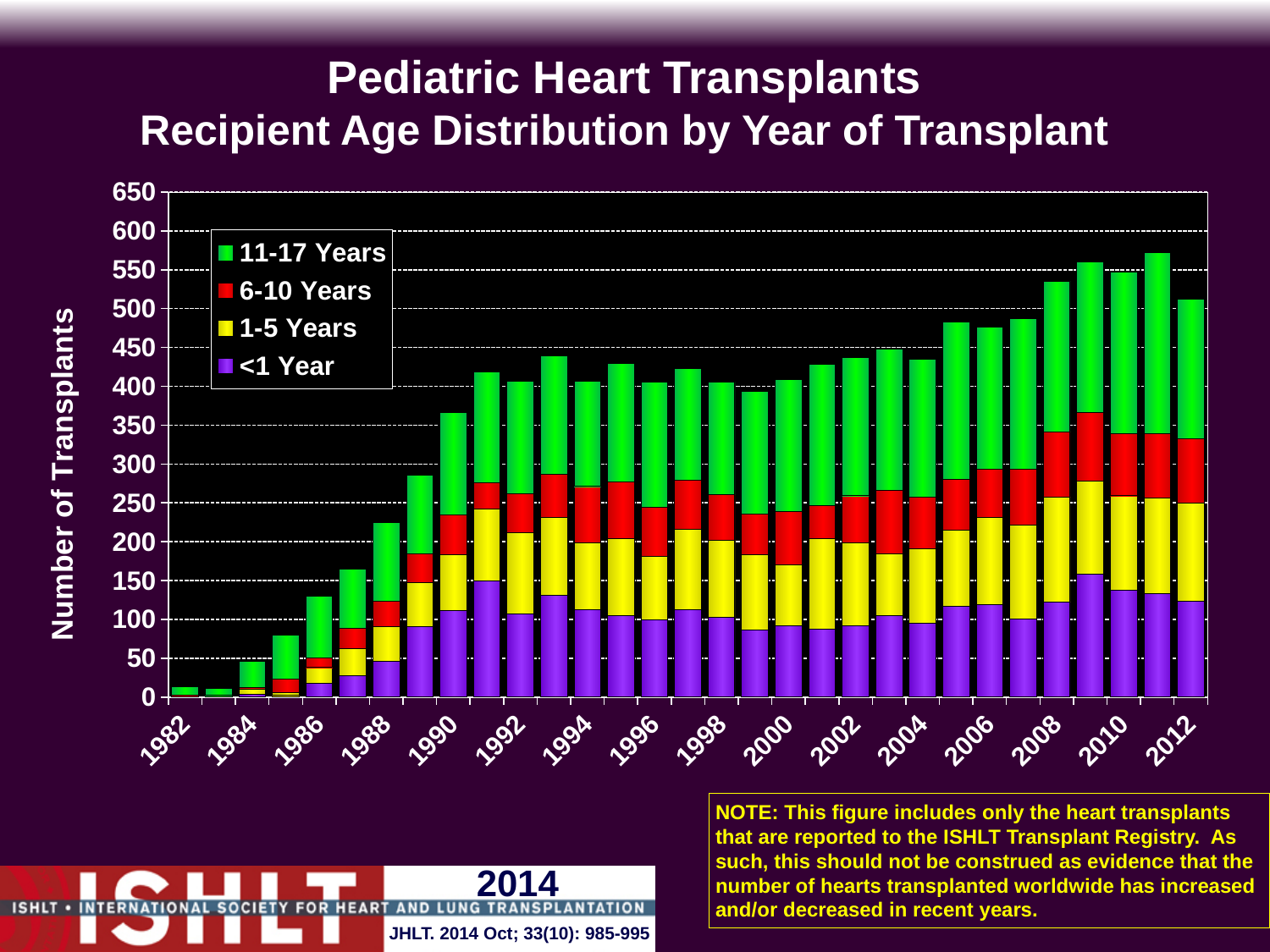
Which age groups are listed in the legend? 11-17 Years, 6-10 Years, 1-5 Years, <1 Year Which year has the taller bar, 2008 or 2004? 2008 How many year labels are printed along the x axis? 16 Do the total transplant numbers rise or fall from 1982 to 1990? rise Is the total number of transplants for 1982 greater or less than 50? less Which year has the taller bar, 1990 or 2000? 2000 Is the total number of transplants for 1988 greater or less than 250? less Is the total number of transplants for 2012 greater or less than 450? greater What kind of chart is shown on the slide? Stacked bar chart How many series does the legend list? 4 What is the title of the y axis? Number of Transplants